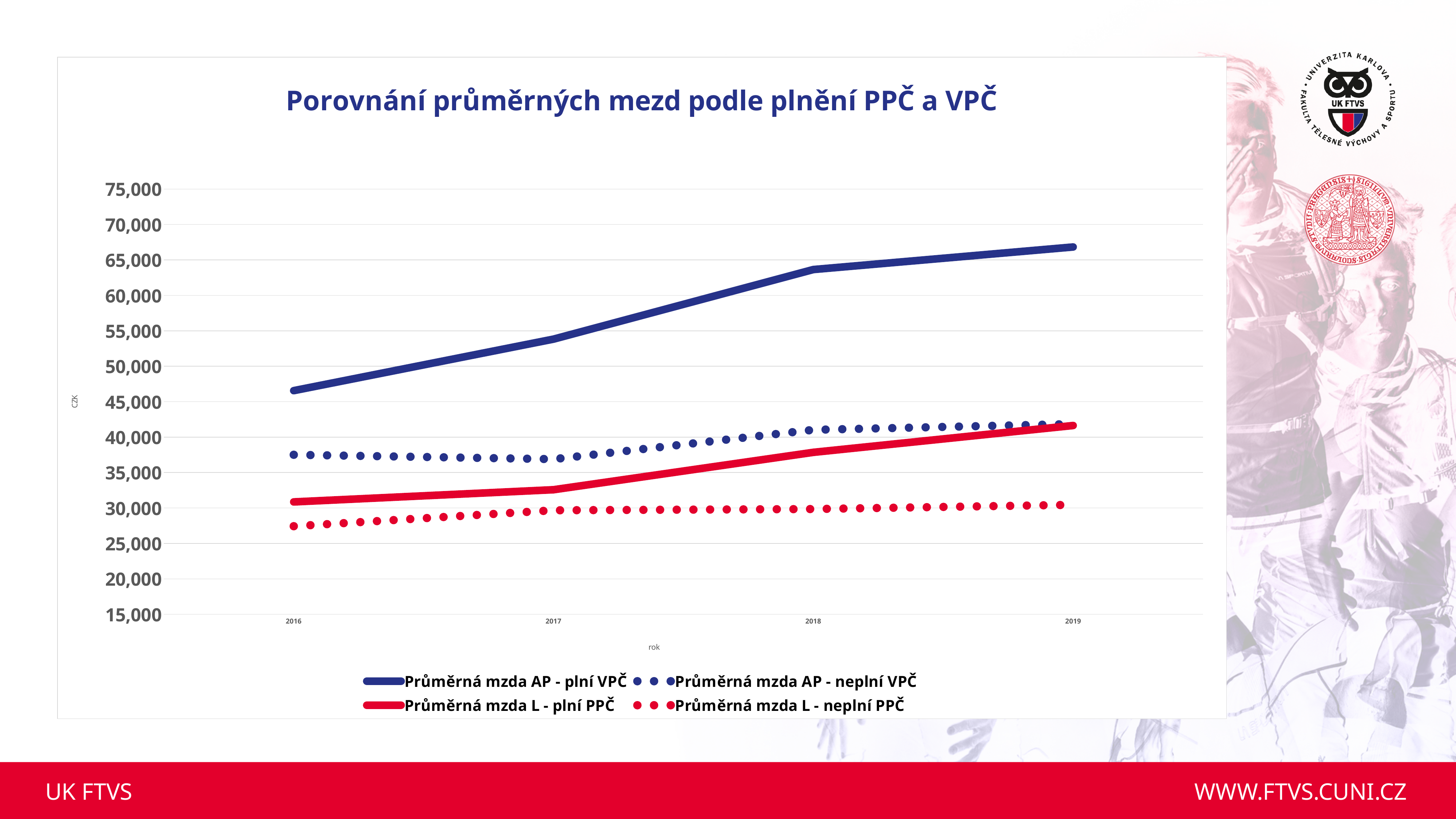
What kind of chart is shown on the slide? line chart Is the value for Průměrná mzda AP - plní VPČ in 2019 greater or less than 65,000? greater What is the label of the y axis? CZK Is the value for Průměrná mzda L - neplní PPČ in 2016 greater or less than 30,000? less What is the title of the chart? Porovnání průměrných mezd podle plnění PPČ a VPČ Which series has the lowest value in 2016? Průměrná mzda L - neplní PPČ Is the value for Průměrná mzda AP - plní VPČ in 2016 greater or less than 50,000? less Does the value for Průměrná mzda AP - plní VPČ rise or fall from 2016 to 2019? rise How many series does the legend list? 4 In 2016, which is larger: Průměrná mzda AP - plní VPČ or Průměrná mzda AP - neplní VPČ? Průměrná mzda AP - plní VPČ Which series has the highest value in 2019? Průměrná mzda AP - plní VPČ How many years are shown on the x axis? 4